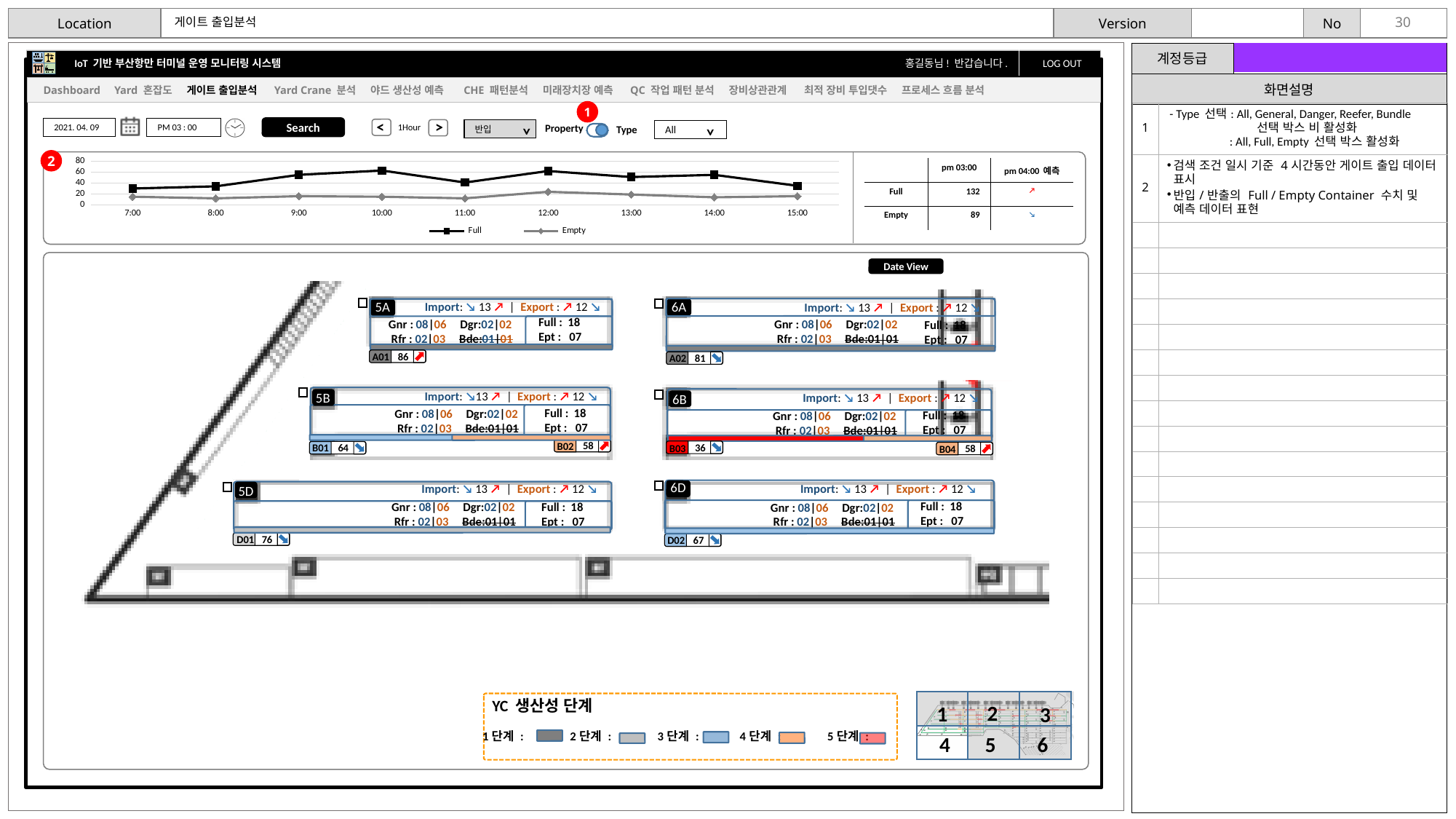
What are the two series named in the line chart's legend? Full and Empty What kind of chart is shown at the top of the slide? line chart Does the Full series rise or fall from 7:00 to 10:00? rise Is the Full value at 12:00 greater or less than 40? greater How many time points are shown along the x axis of the line chart? 9 For the Full series, which is larger, the value at 10:00 or the value at 11:00? 10:00 How many series does the legend of the line chart list? 2 Is the Full value at 7:00 greater or less than 40? less At 10:00, which series has the larger value, Full or Empty? Full What is the highest value shown on the y axis of the line chart? 80 Is the Full value at 10:00 greater or less than 40? greater